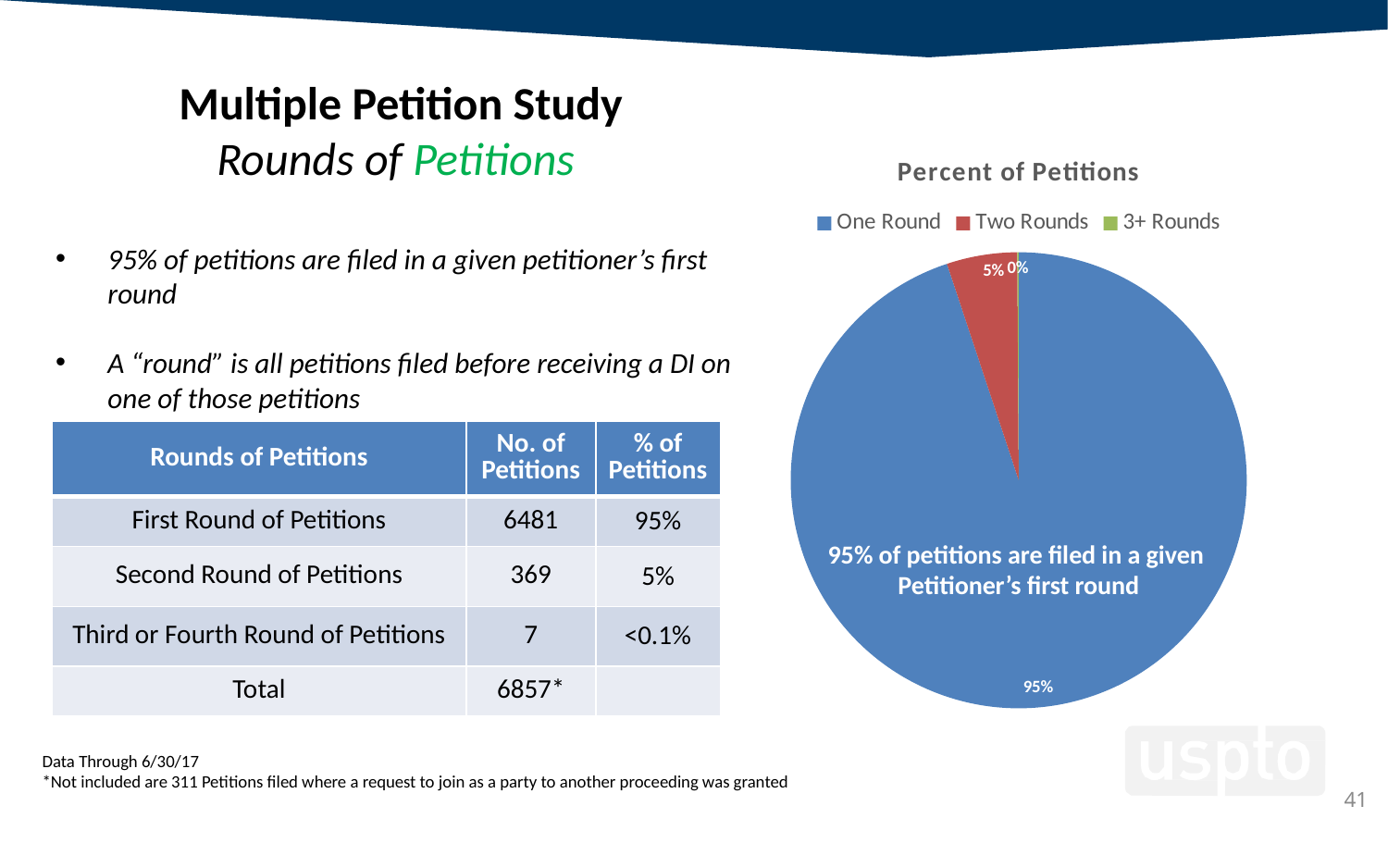
Which slice of the pie is the largest? One Round What share of the pie does Two Rounds represent? 5% What is the difference in percentage points between the One Round slice and the Two Rounds slice? 90 How many entries does the chart's legend list? 3 What share of the pie does 3+ Rounds represent? 0% Which slice of the pie is the smallest? 3+ Rounds Which is larger, the One Round slice or the Two Rounds slice? One Round How many slices does the pie chart have? 3 What colour is the One Round slice? blue What is the title of the chart? Percent of Petitions What share of the pie does One Round represent? 95% What kind of chart is shown on the slide? pie chart